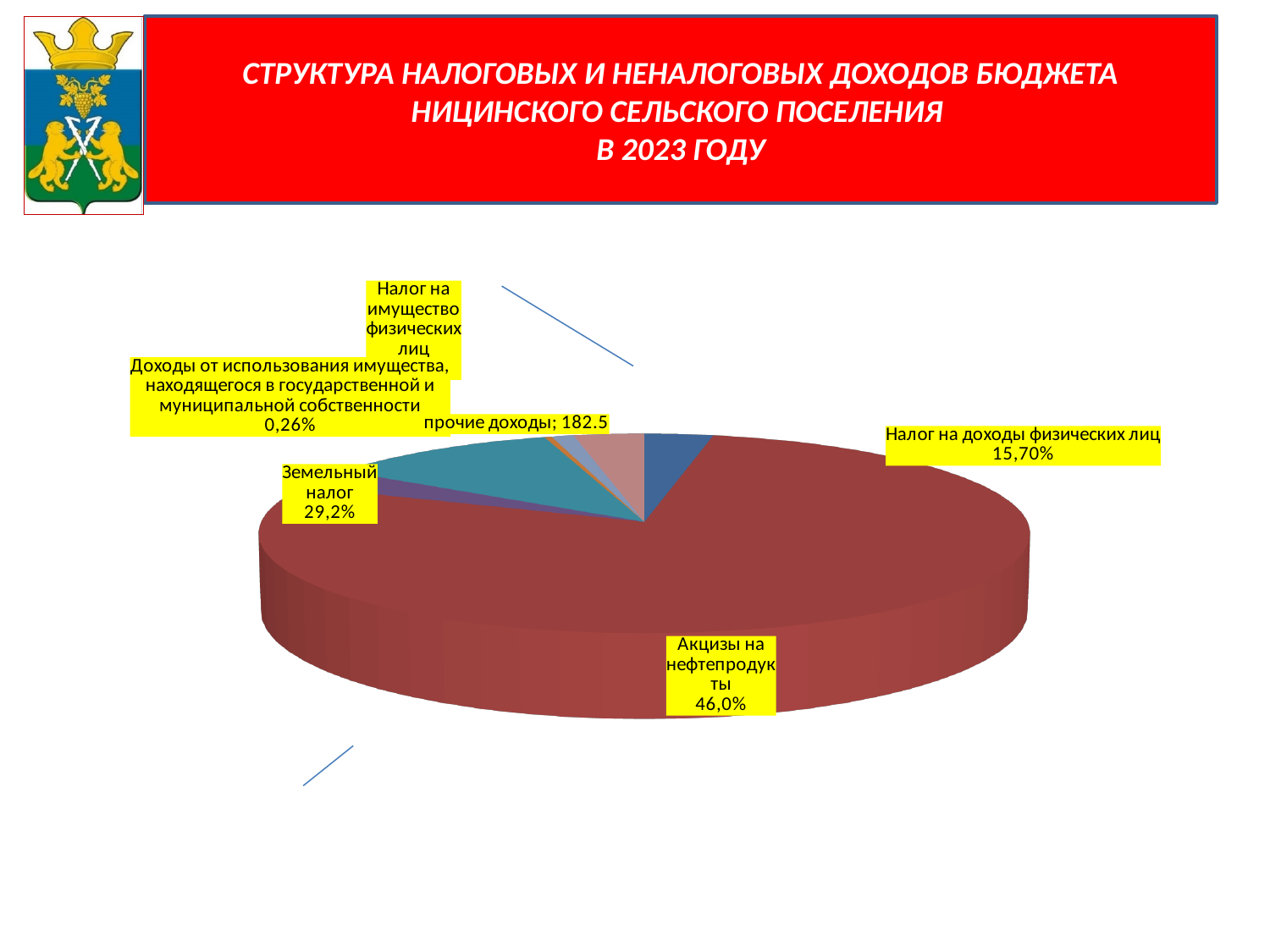
By how many percentage points does the share of Акцизы на нефтепродукты exceed that of Земельный налог? 16,8% What type of chart is shown on the slide? Pie chart What share is shown for Налог на доходы физических лиц? 15,70% Which has the larger share: Земельный налог or Налог на доходы физических лиц? Земельный налог Which category has the smallest labelled percentage share? Доходы от использования имущества, находящегося в государственной и муниципальной собственности Which year does the slide title say the budget revenue structure refers to? 2023 What value is printed next to the label прочие доходы? 182.5 How many categories are labelled on the pie chart? 6 What share is shown for Земельный налог? 29,2% What share is shown for Доходы от использования имущества, находящегося в государственной и муниципальной собственности? 0,26% Which category has the largest labelled share of the pie? Акцизы на нефтепродукты What share of the pie is labelled for Акцизы на нефтепродукты? 46,0%